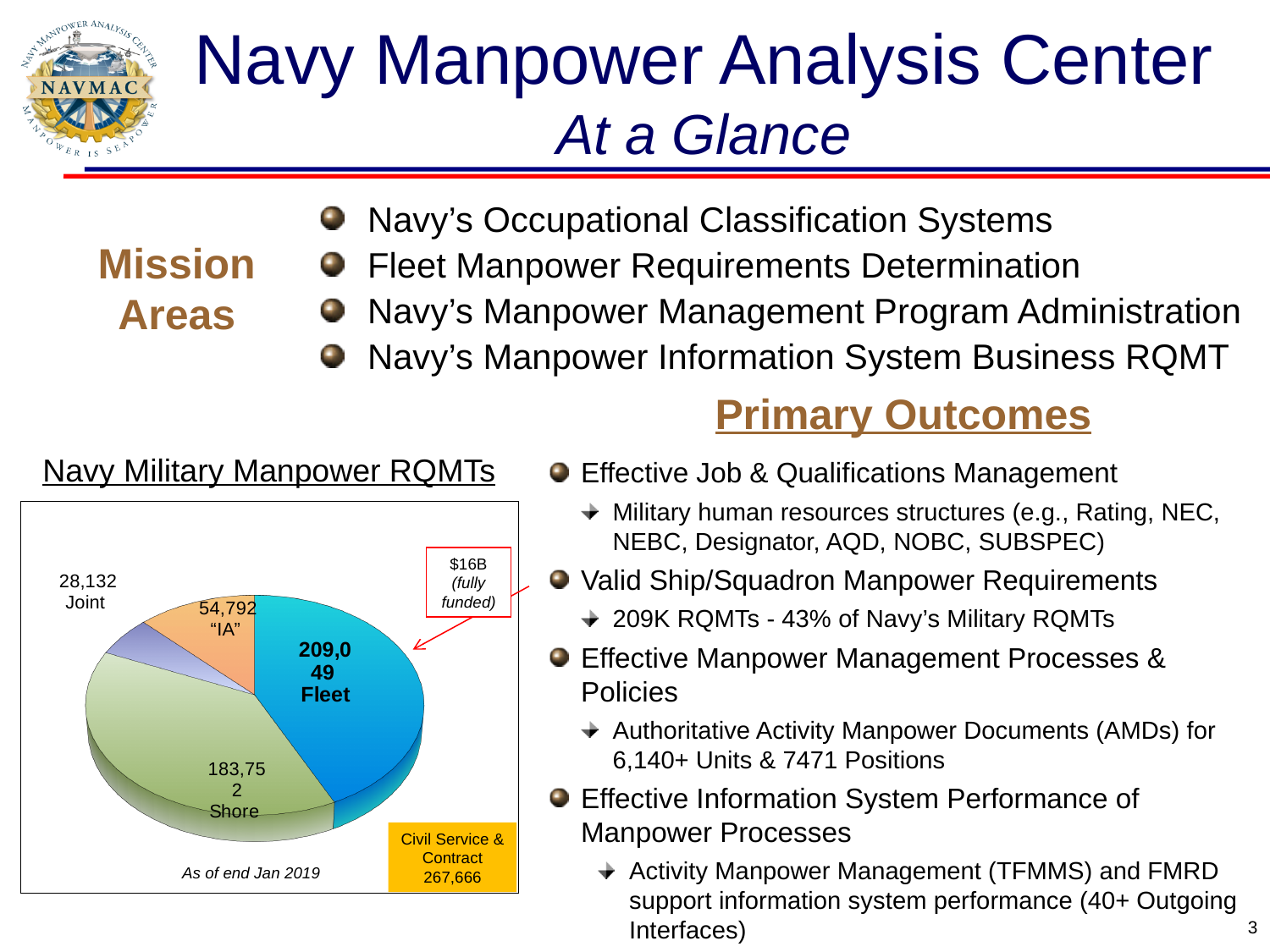
What date note is printed at the bottom of the pie chart? As of end Jan 2019 Which slice of the pie chart is the smallest? Joint How many slices does the Navy Military Manpower RQMTs pie chart have? 4 What is the value of the Fleet slice in the pie chart? 209,049 Which is larger in the pie chart, the "IA" slice or the Joint slice? "IA" Which slice of the pie chart is the largest? Fleet What dollar amount does the callout pointing to the Fleet slice show? $16B What kind of chart is shown under the heading "Navy Military Manpower RQMTs"? Pie chart What is the value of the Joint slice in the pie chart? 28,132 What is the value of the Shore slice in the pie chart? 183,752 What is the value of the "IA" slice in the pie chart? 54,792 What is the difference between the Fleet and Shore values in the pie chart? 25,297